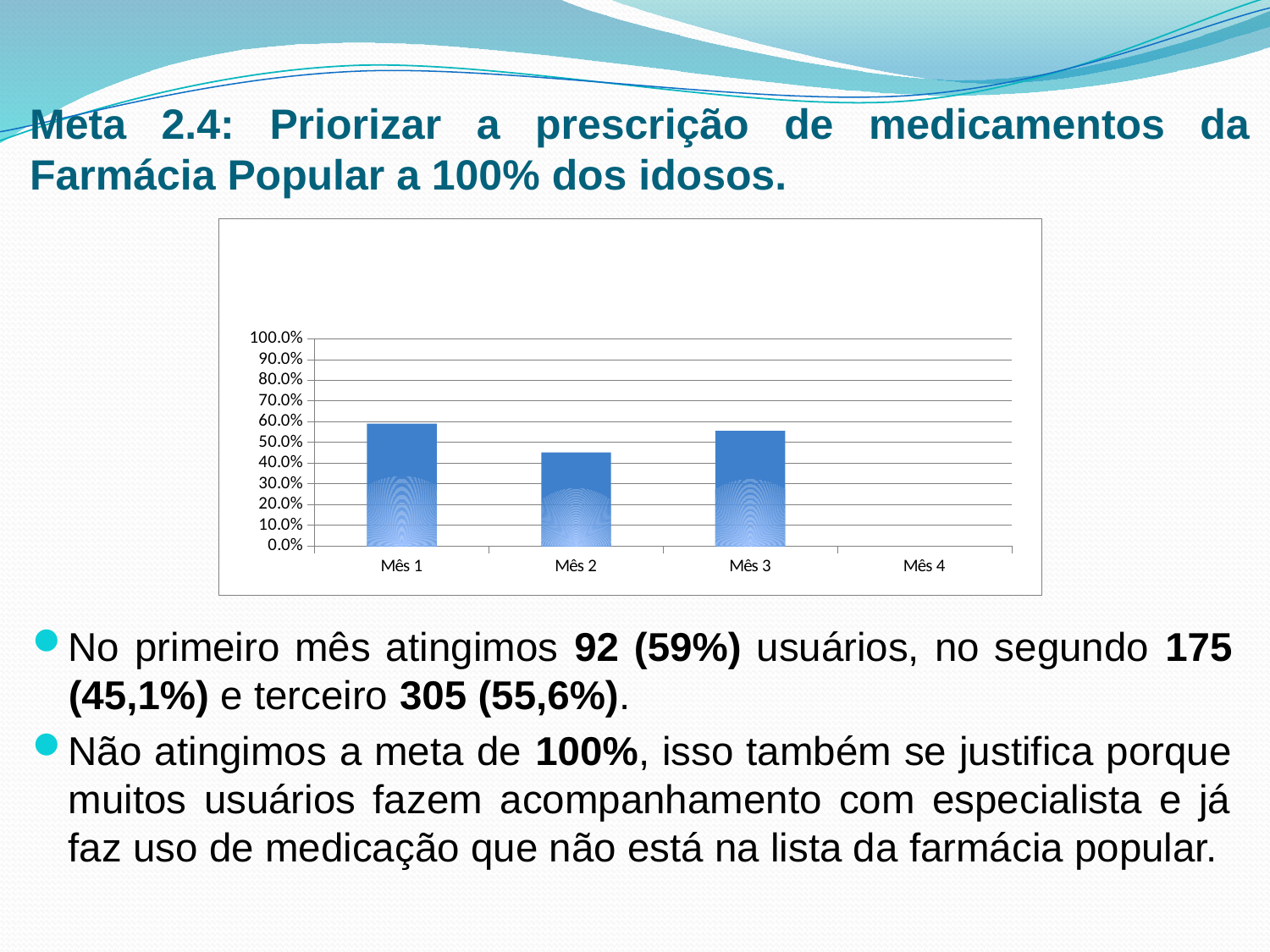
What is the highest tick label shown on the y axis of the chart? 100.0% Is the value for Mês 3 greater or less than 50.0%? greater How many categories are shown on the x axis of the chart? 4 Does the value rise or fall from Mês 1 to Mês 2? fall Which month has the tallest bar in the chart? Mês 1 Is the value for Mês 2 greater or less than 40.0%? greater Among Mês 1, Mês 2 and Mês 3, which month has the lowest value in the chart? Mês 2 What kind of chart is shown on the slide? bar chart Is the value for Mês 1 greater or less than 50.0%? greater Which month on the x axis has no bar plotted? Mês 4 Which is larger, the value for Mês 1 or the value for Mês 2? Mês 1